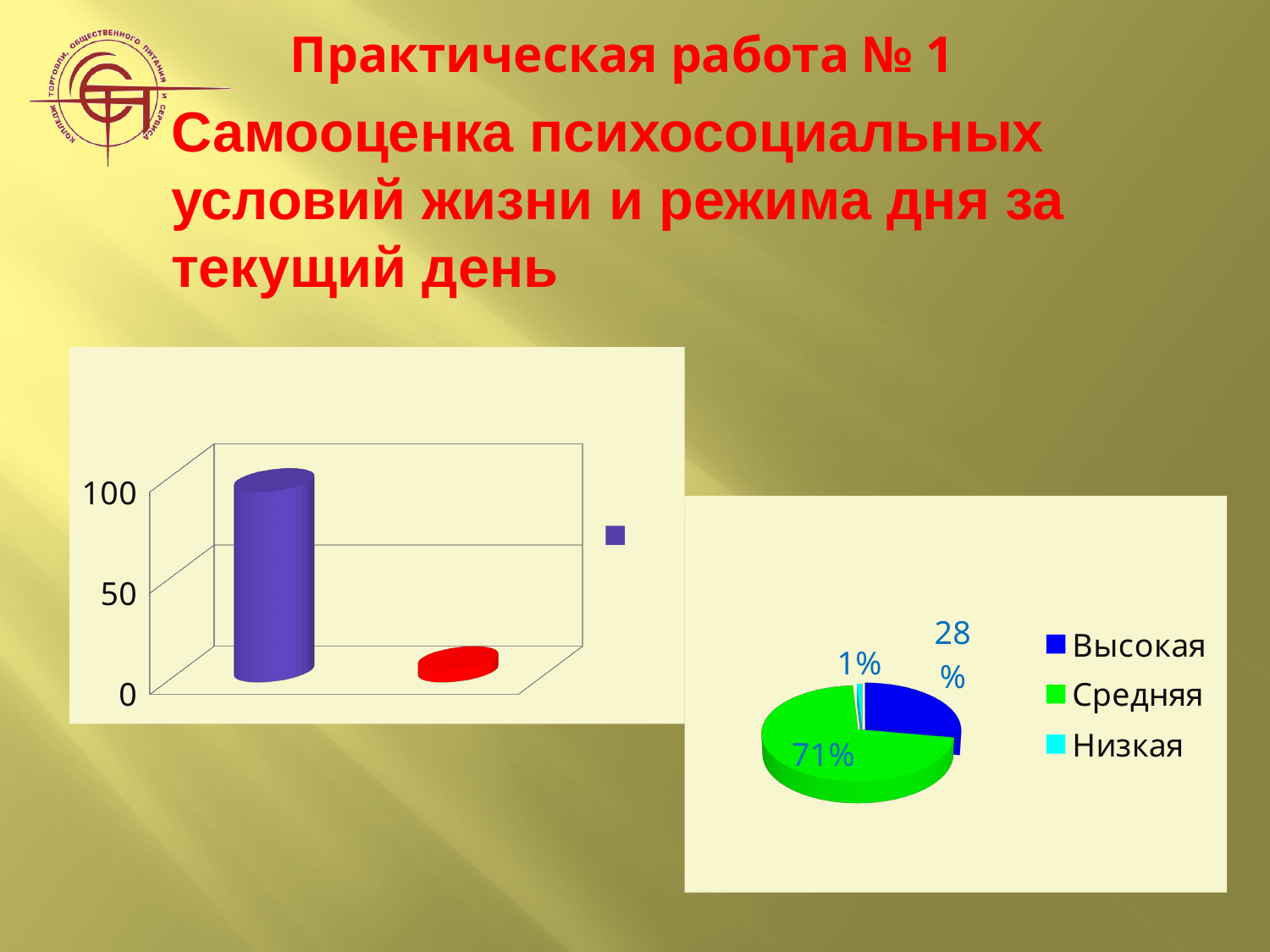
In the pie chart on the right, which category has the largest share? Средняя What kind of chart is the chart on the left of the slide? bar chart In the pie chart on the right, what share does Высокая have? 28% In the bar chart on the left, is the value of the purple bar greater or less than 50? greater What kind of chart is the chart on the right of the slide? pie chart In the pie chart on the right, what is the difference between the shares of Средняя and Высокая? 43% In the pie chart on the right, which is larger: Высокая or Низкая? Высокая In the pie chart on the right, what share does Средняя have? 71% How many categories does the legend of the pie chart on the right list? 3 In the bar chart on the left, which bar is taller: the purple bar or the red bar? the purple bar In the pie chart on the right, what share does Низкая have? 1% In the pie chart on the right, which category has the smallest share? Низкая